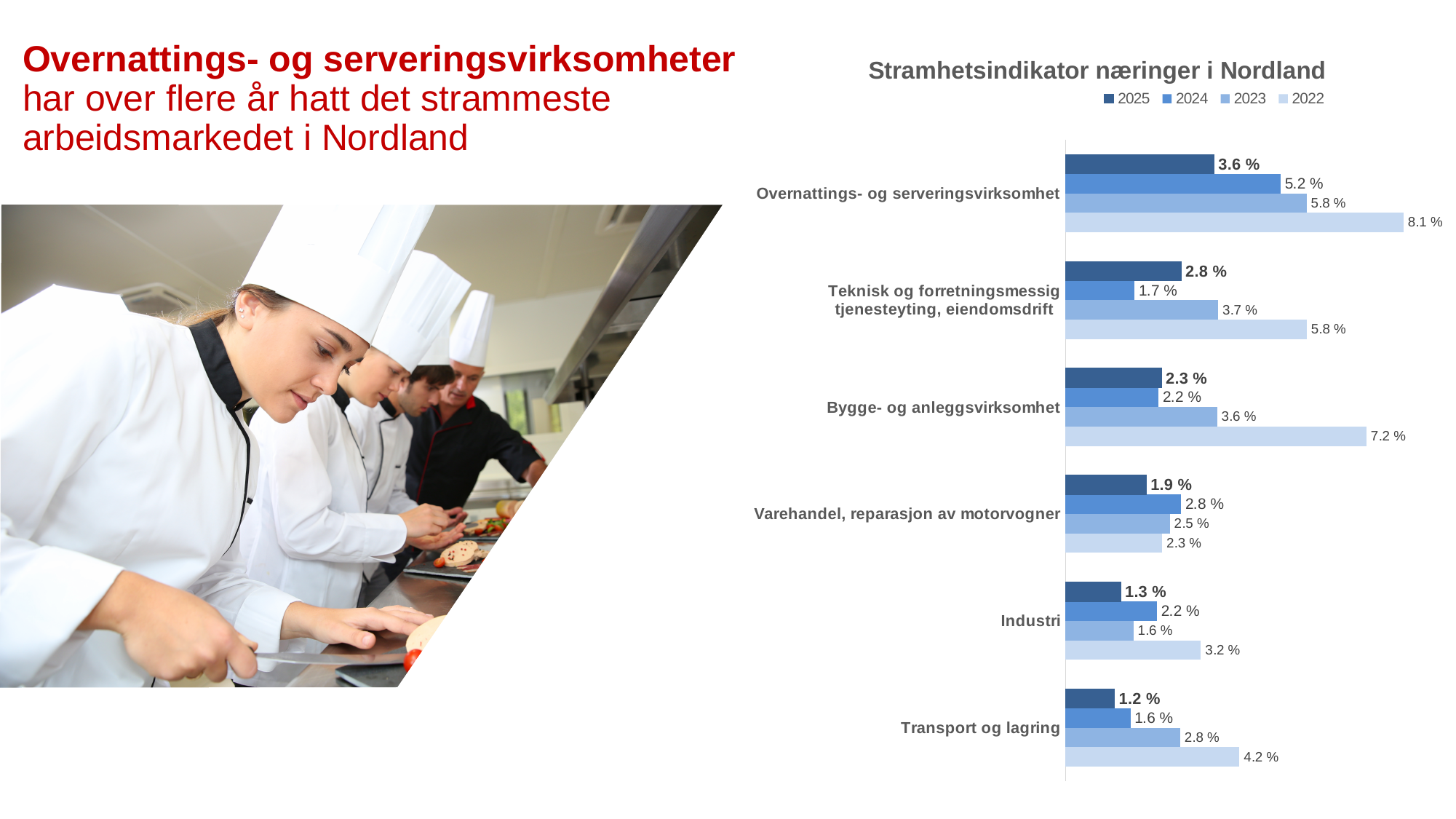
How many categories are shown on the chart? 6 What is the difference between the 2022 and 2025 values for Overnattings- og serveringsvirksomhet? 4.5 % What kind of chart is shown? Bar chart What is the 2024 value for Industri? 2.2 % Which category has the highest 2025 value? Overnattings- og serveringsvirksomhet What is the title of the chart? Stramhetsindikator næringer i Nordland What is the 2025 value for Overnattings- og serveringsvirksomhet? 3.6 % How many series does the legend list? 4 What is the 2023 value for Transport og lagring? 2.8 % Which category has the lowest 2025 value? Transport og lagring Which is larger for Teknisk og forretningsmessig tjenesteyting, eiendomsdrift: the 2025 value or the 2024 value? 2025 What is the 2022 value for Bygge- og anleggsvirksomhet? 7.2 %